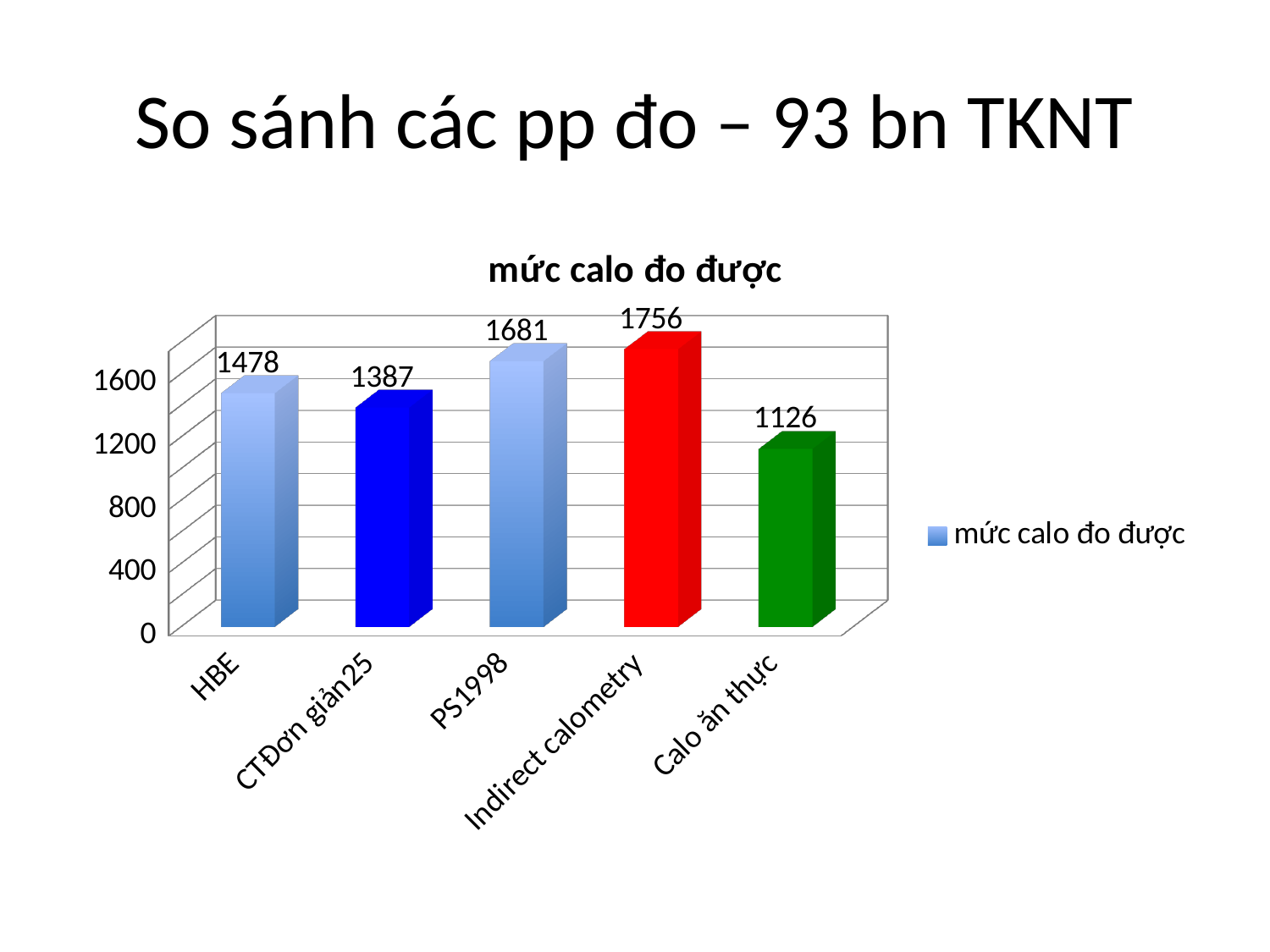
What is the title of the chart? mức calo đo được What is the value for PS1998? 1681 What is the value for Calo ăn thực? 1126 What kind of chart is shown? Bar chart What is the difference between the values for HBE and CTĐơn giản25? 91 What is the difference between the values for Indirect calometry and Calo ăn thực? 630 How many categories are shown on the x axis? 5 Which category has the lowest value? Calo ăn thực Which is larger, the value for PS1998 or the value for HBE? PS1998 Which category has the highest value? Indirect calometry What is the value for Indirect calometry? 1756 What is the value for HBE? 1478